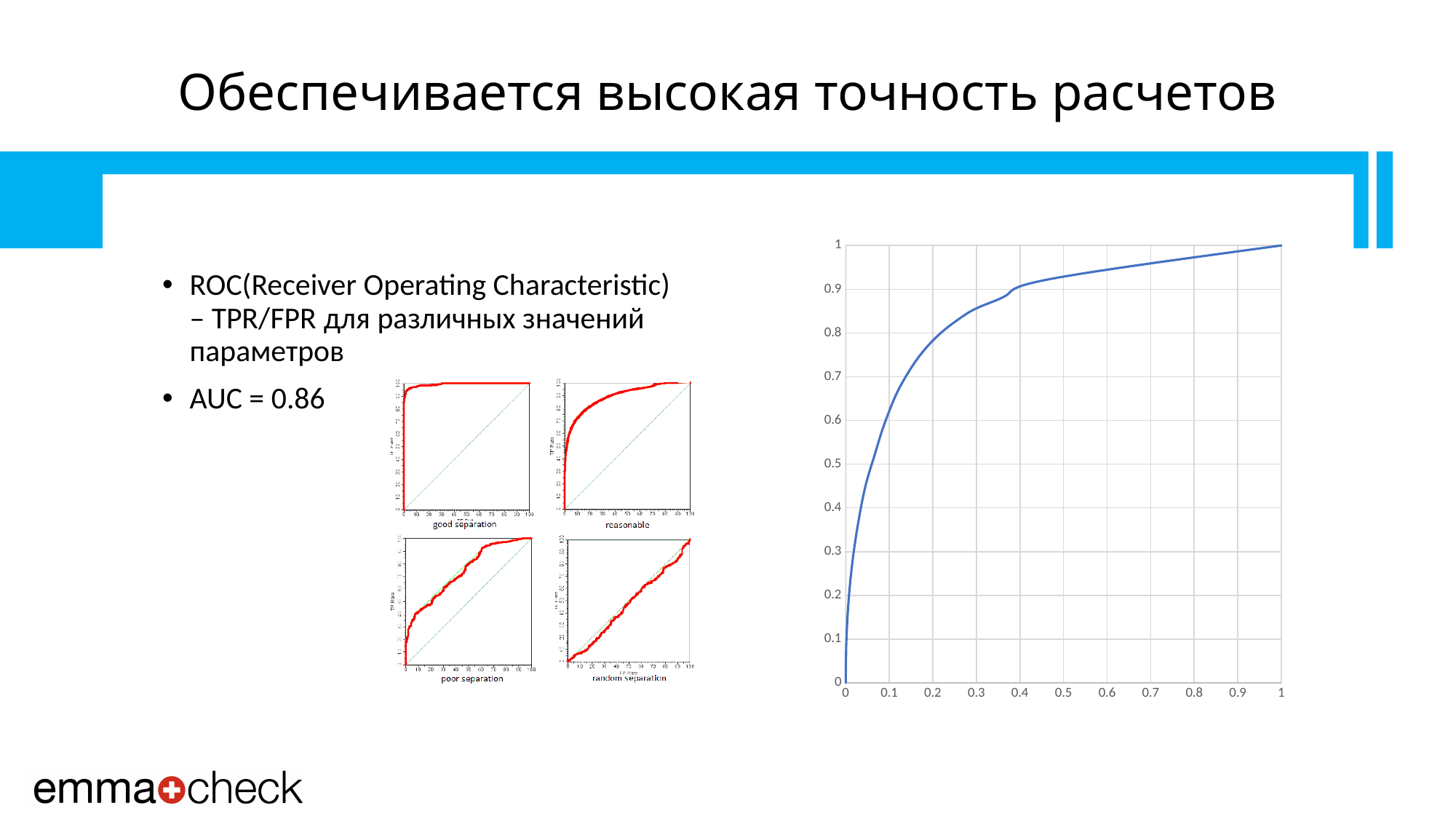
In the large chart on the right, what is the value of the curve at x = 0? 0 In the large chart on the right, is the value of the curve at x = 0.9 greater or less than 0.9? greater In the large chart on the right, do the values rise or fall as the x axis increases from 0 to 1? rise What colour is the curve in the large chart on the right? blue What kind of chart is the large chart on the right of the slide? line chart In the large chart on the right, is the value of the curve at x = 0.3 greater or less than 0.9? less In the large chart on the right, is the value of the curve at x = 0.2 greater or less than 0.7? greater How many tick labels are shown on the x axis of the large chart on the right? 11 In the large chart on the right, what is the highest value shown on the y axis? 1 In the large chart on the right, what is the value of the curve at x = 1? 1